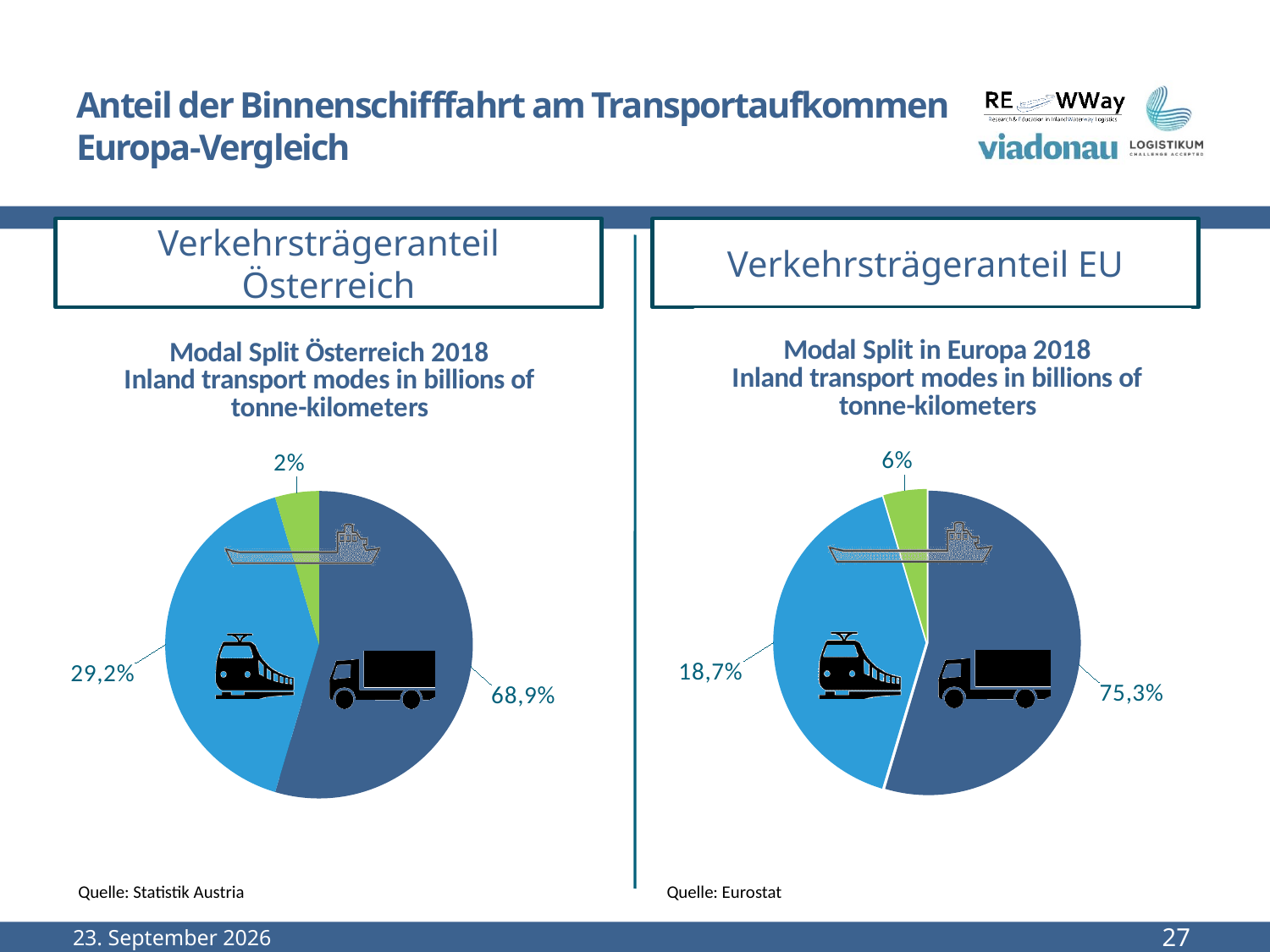
How many slices does the 'Modal Split in Europa 2018' pie chart have? 3 In the 'Modal Split Österreich 2018' chart, what share is shown for the slice with the truck icon? 68,9% What type of chart is used for 'Modal Split Österreich 2018'? Pie chart In the 'Modal Split in Europa 2018' chart, which transport mode icon marks the smallest slice? The ship In the 'Modal Split Österreich 2018' chart, what share is shown for the slice with the train icon? 29,2% In the 'Modal Split in Europa 2018' chart, what share is shown for the slice with the truck icon? 75,3% Which is larger: the ship slice in the 'Modal Split Österreich 2018' chart or the ship slice in the 'Modal Split in Europa 2018' chart? Modal Split in Europa 2018 What is the difference between the truck share in the 'Modal Split in Europa 2018' chart and the truck share in the 'Modal Split Österreich 2018' chart? 6,4% In the 'Modal Split in Europa 2018' chart, what share is shown for the slice with the train icon? 18,7% In the 'Modal Split Österreich 2018' chart, which transport mode icon marks the largest slice? The truck In the 'Modal Split Österreich 2018' chart, what share is shown for the green slice with the ship icon? 2% In the 'Modal Split in Europa 2018' chart, what share is shown for the green slice with the ship icon? 6%